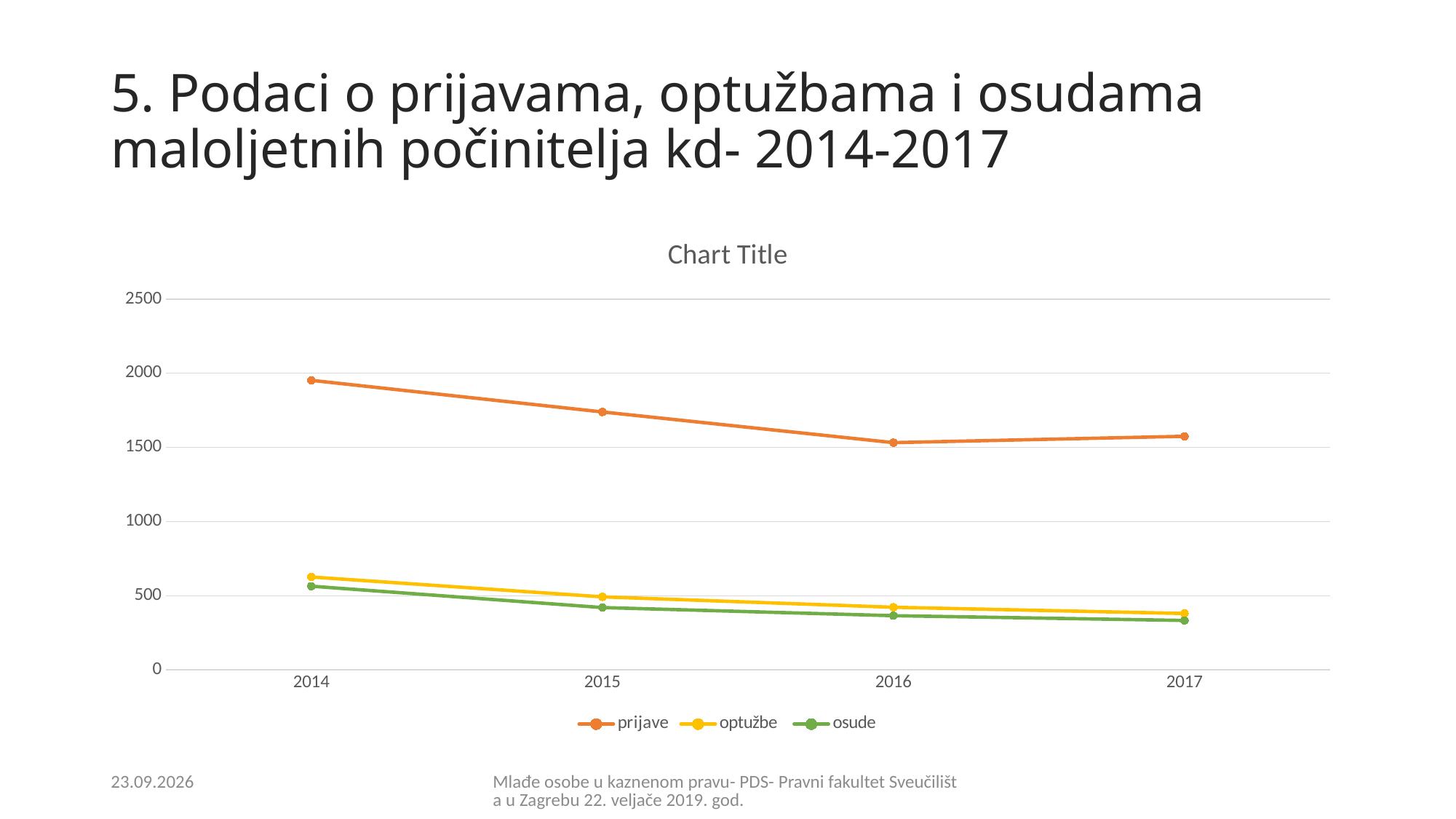
Is the value for prijave in 2014 greater or less than 1500? greater Which series is drawn in orange? prijave Is the value for optužbe in 2014 greater or less than 500? greater Is the value for prijave in 2015 greater or less than 2000? less Do the values for osude rise or fall from 2014 to 2017? fall In which year is the value for prijave highest? 2014 What kind of chart is shown on the slide? line chart How many years are plotted along the x axis? 4 How many series does the legend list? 3 In which year is the value for optužbe lowest? 2017 Which series has the larger value in 2014, optužbe or osude? optužbe